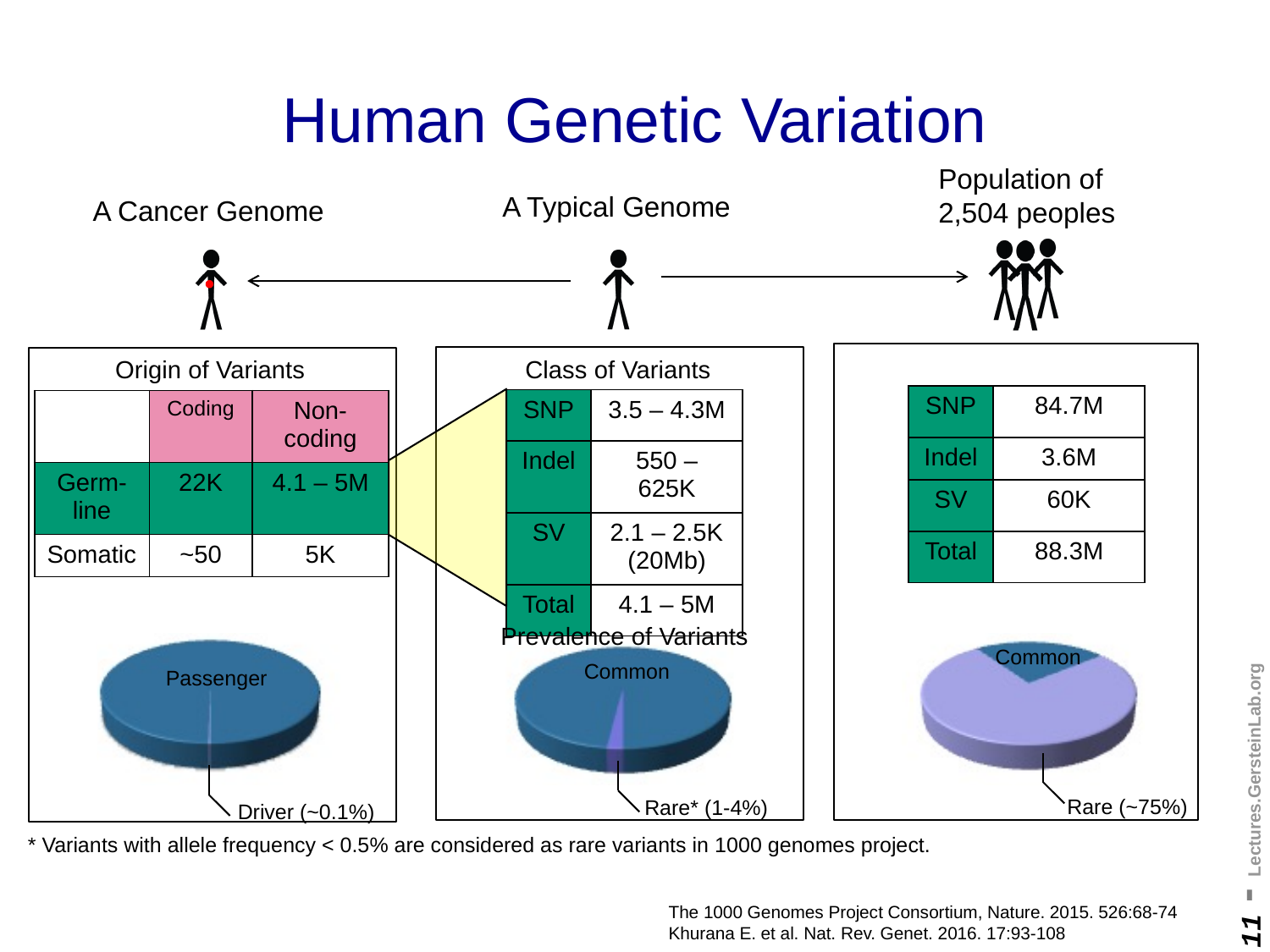
In the 'Population of 2,504 peoples' pie chart, which slice is the smallest? Common In the 'A Cancer Genome' pie chart, what share is printed for the Driver slice? ~0.1% What kind of chart is shown at the bottom of the 'A Cancer Genome' panel? pie chart In the 'A Typical Genome' pie chart, which slice is the largest? Common In the 'Population of 2,504 peoples' pie chart, what share is printed for the Rare slice? ~75% In the 'Population of 2,504 peoples' pie chart, which slice is larger, Common or Rare? Rare How many pie charts are shown on the slide? 3 In the 'A Typical Genome' pie chart, what share is printed for the Rare* slice? 1-4% How many slices does the pie chart in the 'A Cancer Genome' panel have? 2 What are the two slice labels in the 'A Cancer Genome' pie chart? Passenger and Driver In the 'A Cancer Genome' pie chart, which slice is larger, Passenger or Driver? Passenger What is the title printed above the pie chart in the 'A Typical Genome' panel? Prevalence of Variants